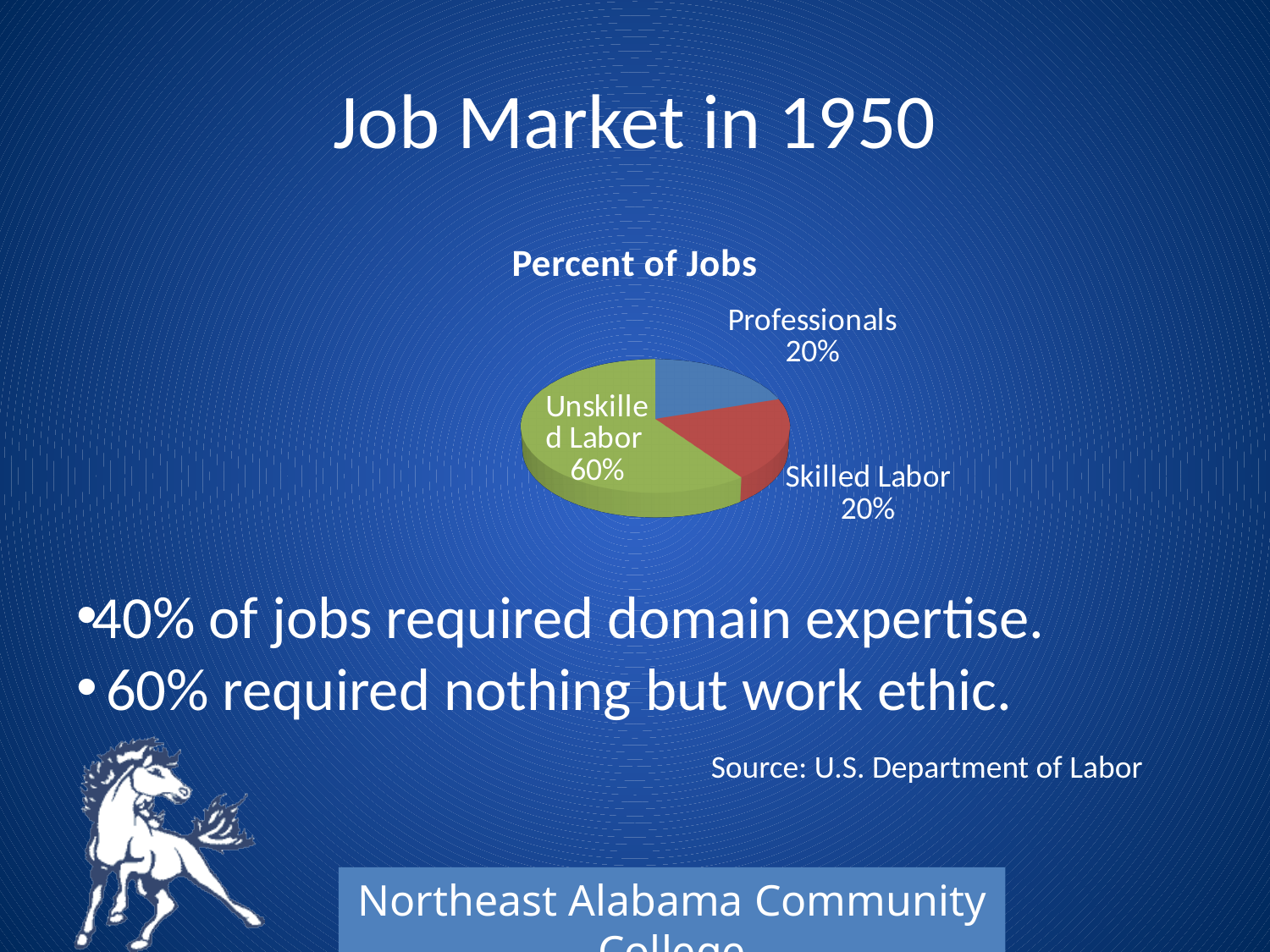
What is the combined share of Professionals and Skilled Labor? 40% What percentage of jobs is shown for Skilled Labor? 20% What percentage of jobs is shown for Unskilled Labor? 60% What is the title of the chart? Percent of Jobs What is the difference between the Unskilled Labor share and the Professionals share? 40% How many slices does the pie chart have? 3 What colour is the Unskilled Labor slice? green Which category has the largest share of the pie? Unskilled Labor What percentage of jobs is shown for Professionals? 20% What kind of chart is shown on the slide? pie chart Which is larger, the share for Unskilled Labor or the share for Skilled Labor? Unskilled Labor